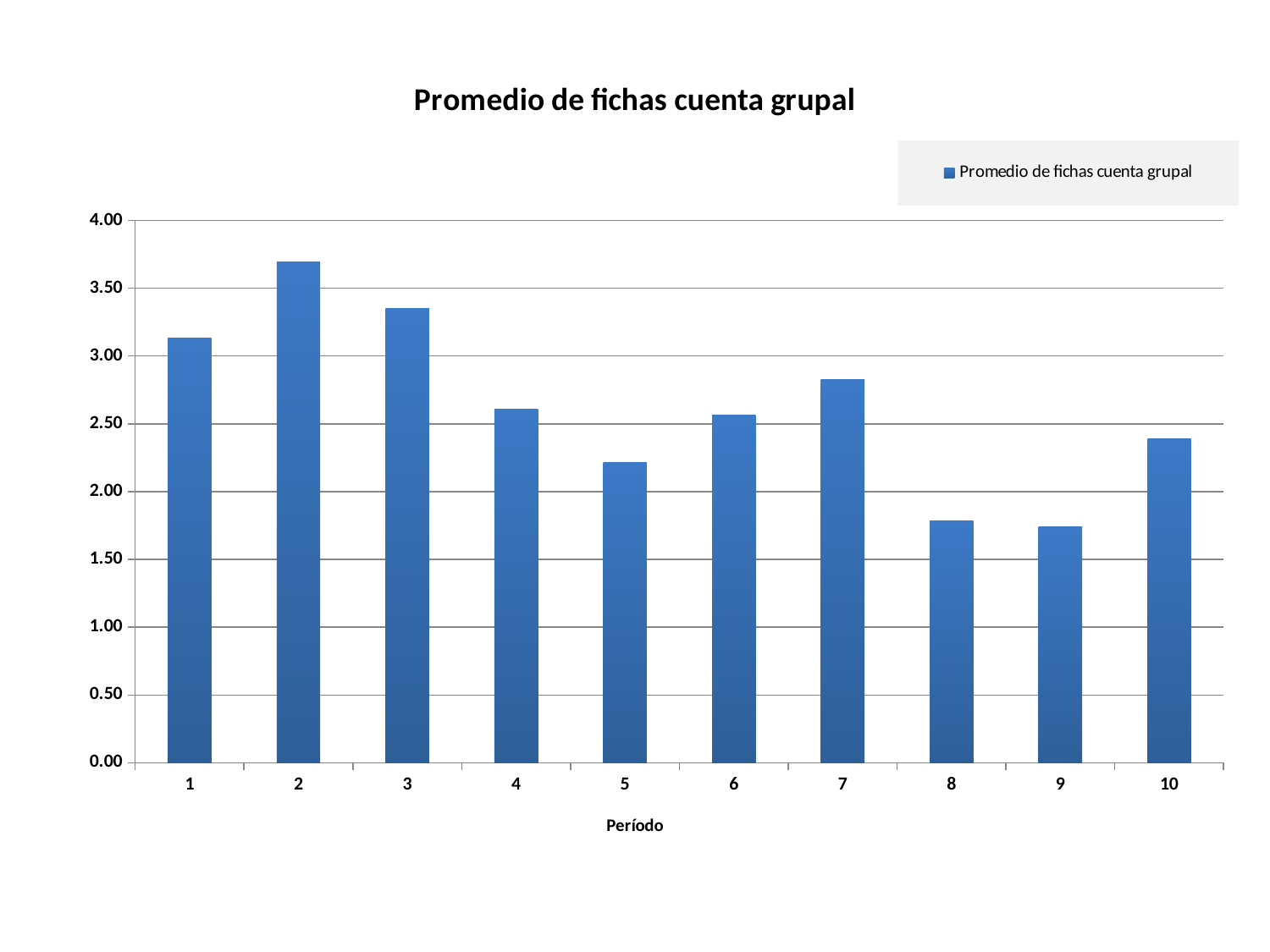
Is the value for period 10 greater or less than 2.50? less How many series does the legend list? 1 Is the value for period 1 greater or less than 3.00? greater Which is larger, the value for period 7 or the value for period 4? period 7 Which period has the highest average? 2 What is the title of the chart? Promedio de fichas cuenta grupal Which is larger, the value for period 1 or the value for period 3? period 3 How many periods are plotted on the x axis? 10 Is the value for period 2 greater or less than 3.50? greater What kind of chart is shown on the slide? bar chart